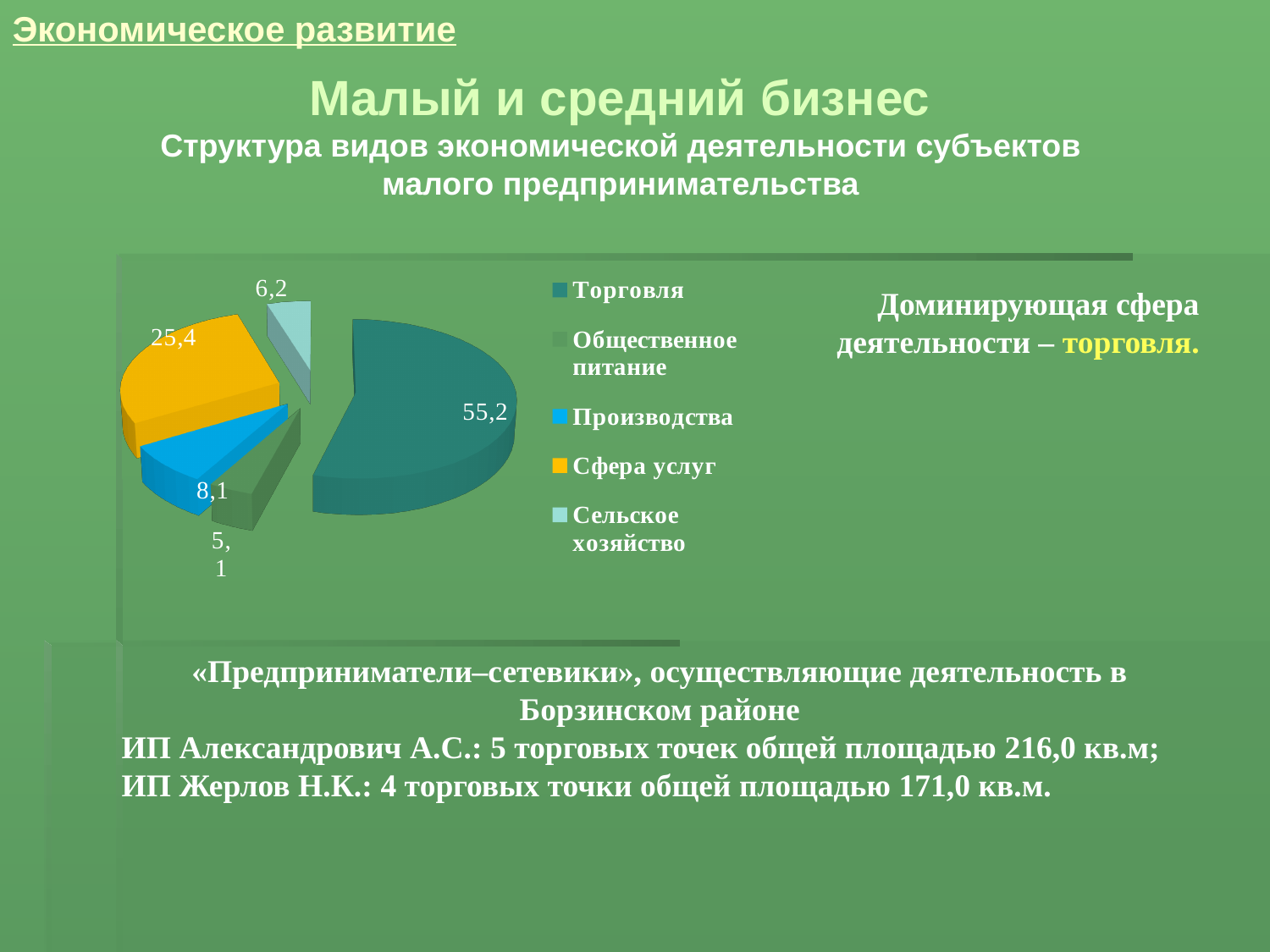
Which is larger, the value for Производства or the value for Сельское хозяйство? Производства What kind of chart is shown on the slide? pie chart What is the value shown for Сфера услуг? 25,4 What is the value shown for Сельское хозяйство? 6,2 What is the value shown for Торговля? 55,2 What is the difference between the values for Торговля and Сфера услуг? 29,8 What colour is the slice for Сфера услуг? yellow What is the value shown for Производства? 8,1 How many entries does the legend list? 5 How many slices does the pie chart have? 5 Which category has the largest slice of the pie? Торговля Which category has the smallest slice of the pie? Общественное питание